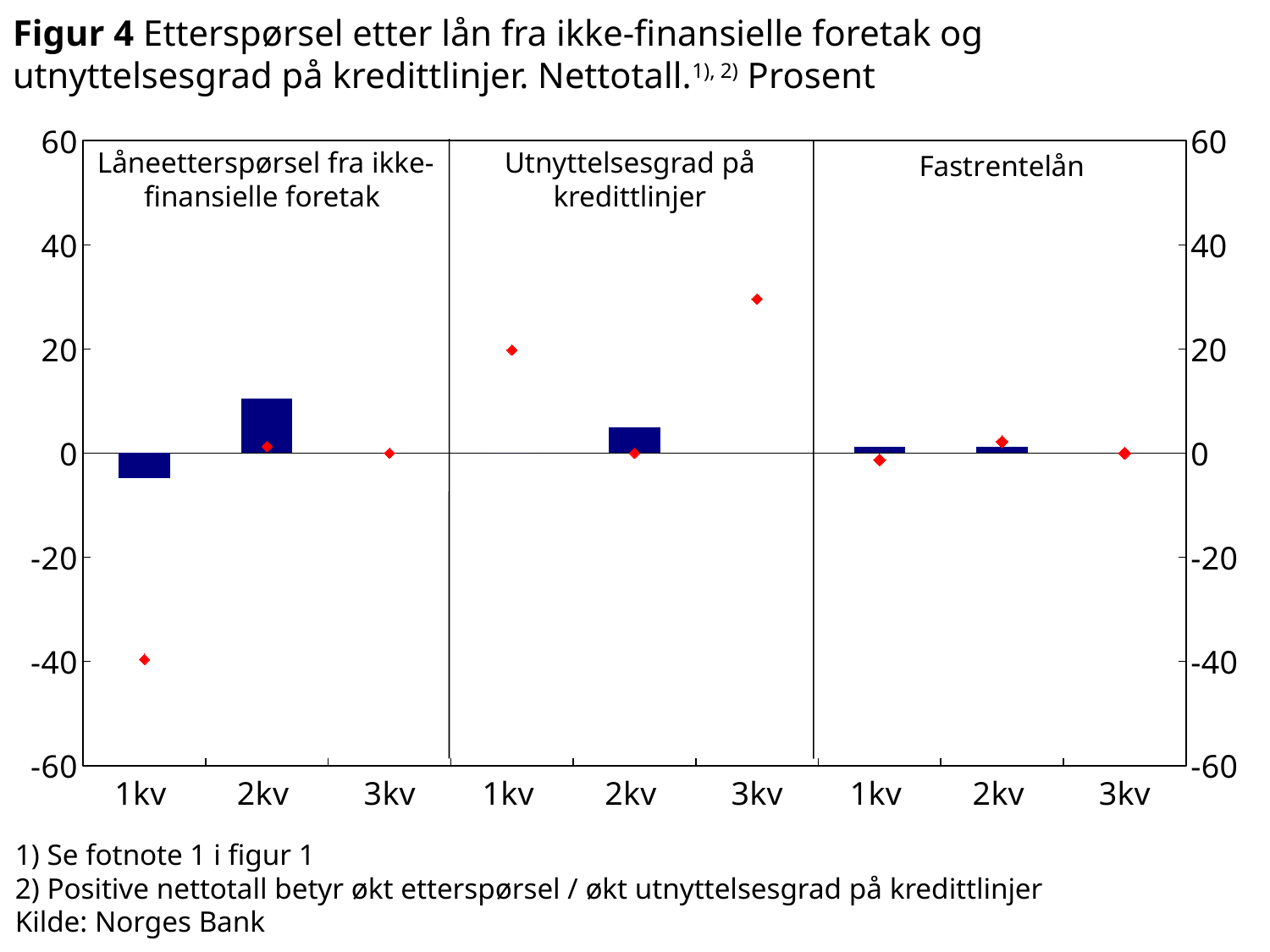
How many panels (sections) does the chart have? 3 What kind of chart is shown on the slide? combination bar and line chart (bars with red diamond markers) What is the source given for the chart? Norges Bank In the 'Låneetterspørsel fra ikke-finansielle foretak' panel, is the red marker for 1kv greater or less than -20? less In the 'Utnyttelsesgrad på kredittlinjer' panel, which quarter has the highest red marker? 3kv How many quarters are shown on the x axis of the 'Fastrentelån' panel? 3 In the 'Utnyttelsesgrad på kredittlinjer' panel, is the red marker for 3kv greater or less than 20? greater What is the figure number of the chart? Figur 4 In the 'Låneetterspørsel fra ikke-finansielle foretak' panel, is the bar for 2kv greater or less than 20? less In the 'Låneetterspørsel fra ikke-finansielle foretak' panel, which quarter has the lowest red marker? 1kv In the 'Låneetterspørsel fra ikke-finansielle foretak' panel, which bar is larger, 1kv or 2kv? 2kv